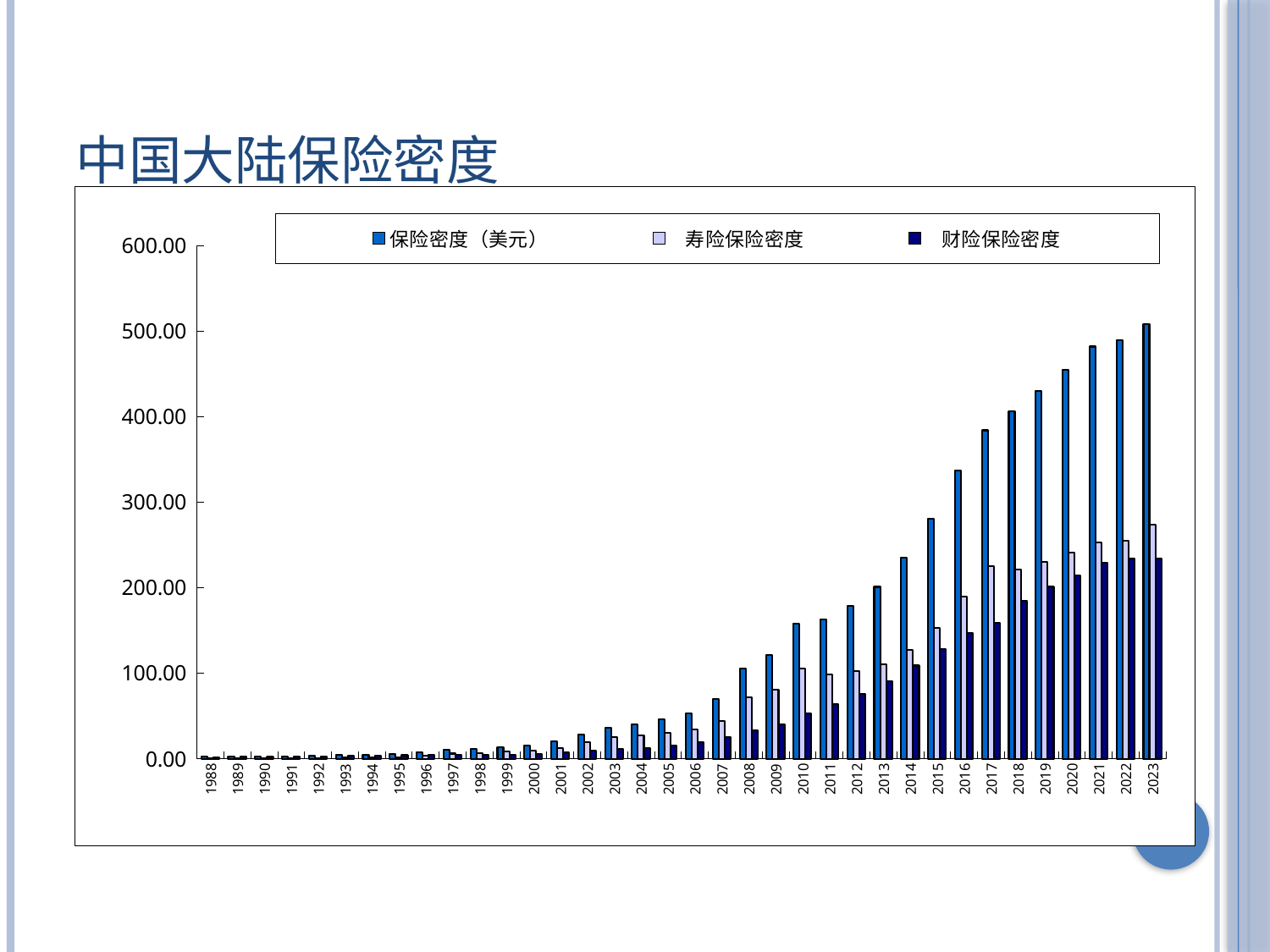
Is the value for 保险密度（美元） in 2016 greater or less than 300.00? greater Which is larger for 保险密度（美元）: the value in 2010 or the value in 2020? 2020 Which year has the highest value for 保险密度（美元）? 2023 Is the value for 财险保险密度 in 2015 greater or less than 100.00? greater Is the value for 保险密度（美元） in 2023 greater or less than 500.00? greater In 2023, which is larger: 寿险保险密度 or 财险保险密度? 寿险保险密度 What kind of chart is shown on the slide? bar chart How many series does the legend list? 3 How many years are shown on the x axis? 36 Do the values for 保险密度（美元） generally rise or fall from 1988 to 2023? rise What is the title of the slide? 中国大陆保险密度